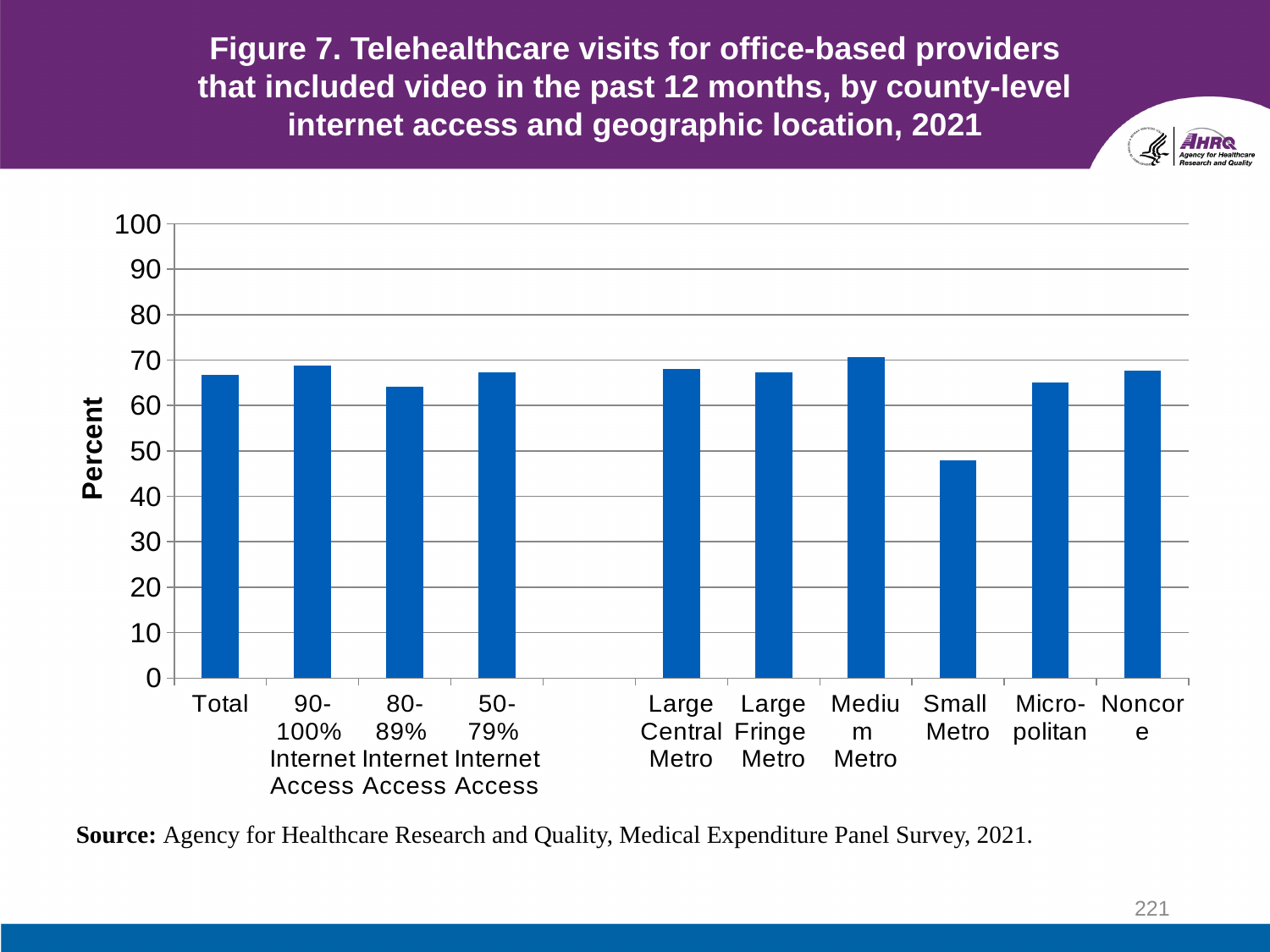
Which is larger, the value for Medium Metro or the value for Small Metro? Medium Metro What year does the chart title say the data is from? 2021 What kind of chart is shown on the slide? Bar chart Which is larger, the value for Small Metro or the value for Micropolitan? Micropolitan Is the value for Small Metro greater or less than 50? less Which category has the lowest value in the chart? Small Metro How many bars are plotted in the chart? 10 What is the label on the vertical axis of the chart? Percent Is the value for 80-89% Internet Access greater or less than 70? less Which category has the highest value in the chart? Medium Metro Is the value for Total greater or less than 60? greater